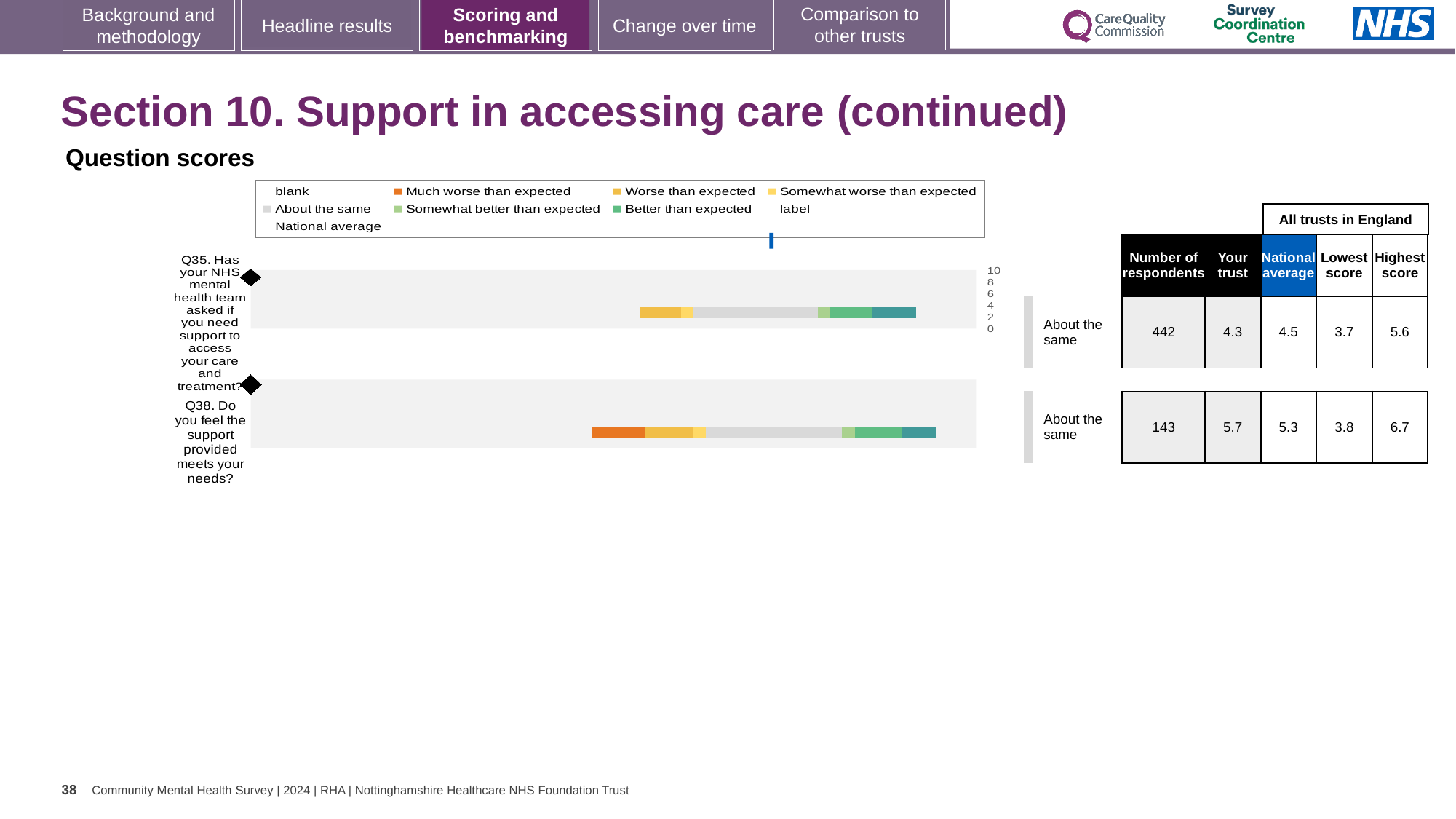
How many respondents answered Q38? 143 What kind of chart is used to show the question scores on this slide? bar chart What is the 'Your trust' score for Q38 (Do you feel the support provided meets your needs?)? 5.7 What is the highest score among all trusts in England for Q38? 6.7 What is the national average score for Q38? 5.3 What benchmark category is shown for both Q35 and Q38? About the same How many respondents answered Q35? 442 What is the 'Your trust' score for Q35 (Has your NHS mental health team asked if you need support to access your care and treatment?)? 4.3 How many questions are plotted in the question scores chart? 2 What is the national average score for Q35? 4.5 What is the difference between the highest and lowest scores across all trusts in England for Q35? 1.9 Which question has the higher 'Your trust' score, Q35 or Q38? Q38